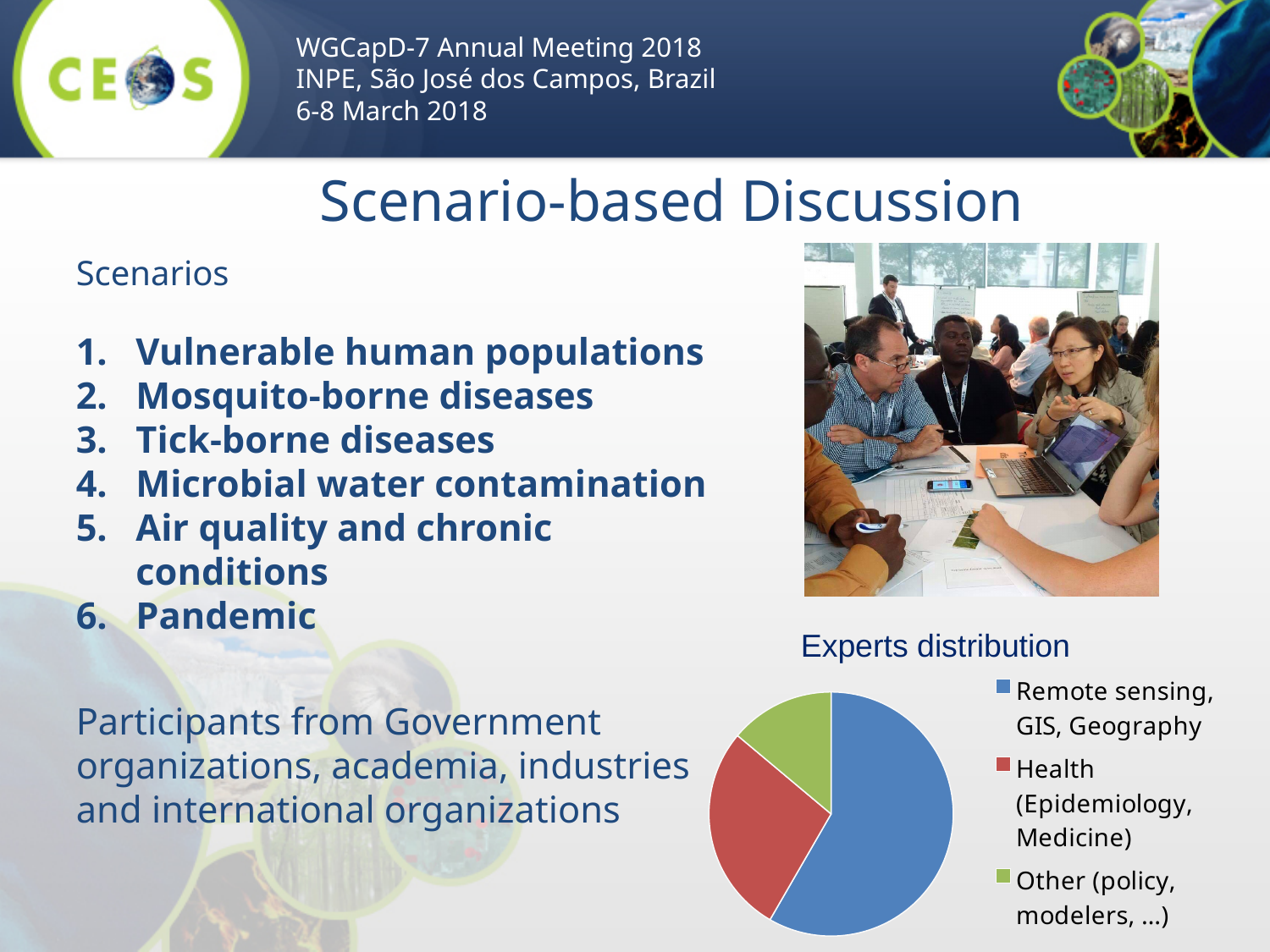
How many slices does the "Experts distribution" pie chart have? 3 Which category has the smallest slice in the "Experts distribution" pie chart? Other (policy, modelers, ...) What kind of chart is shown under the heading "Experts distribution"? pie chart What colour is the Health (Epidemiology, Medicine) slice in the "Experts distribution" pie chart? red What is the title shown above the pie chart on the slide? Experts distribution Which category has the largest slice in the "Experts distribution" pie chart? Remote sensing, GIS, Geography In the "Experts distribution" pie chart, which slice is larger: Remote sensing, GIS, Geography or Health (Epidemiology, Medicine)? Remote sensing, GIS, Geography How many entries does the legend of the "Experts distribution" pie chart list? 3 In the "Experts distribution" pie chart, which slice is larger: Health (Epidemiology, Medicine) or Other (policy, modelers, ...)? Health (Epidemiology, Medicine)